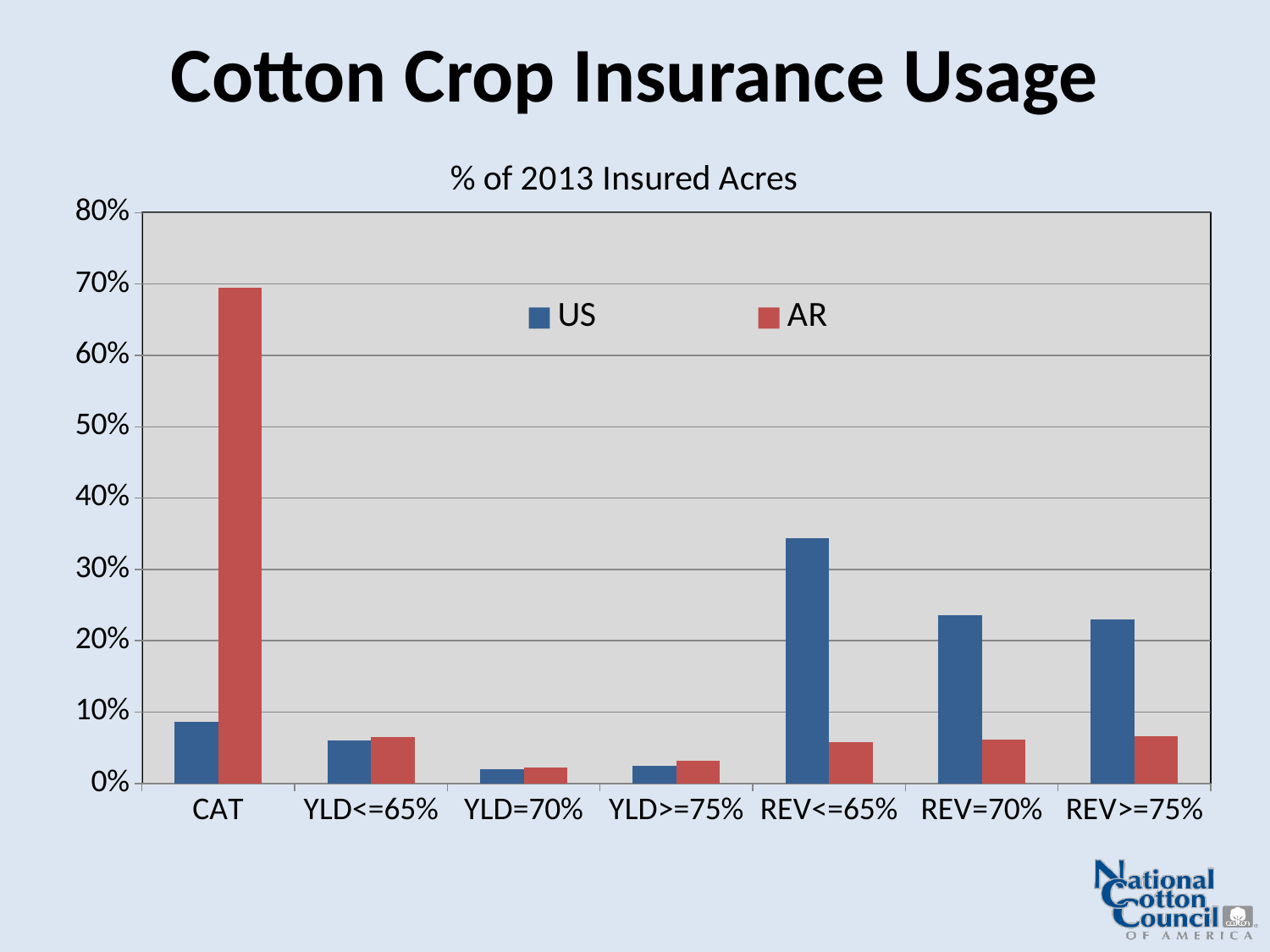
Is the AR value for CAT greater or less than 60%? greater What is the subtitle shown above the chart? % of 2013 Insured Acres Is the AR value for REV<=65% greater or less than 10%? less Which category has the highest value for the AR series? CAT How many categories are shown on the x axis? 7 Which category has the highest value for the US series? REV<=65% How many series does the legend list? 2 What kind of chart is shown on the slide? bar chart For the CAT category, which series has the larger value, US or AR? AR For the REV<=65% category, which series has the larger value, US or AR? US Is the US value for REV=70% greater or less than 20%? greater